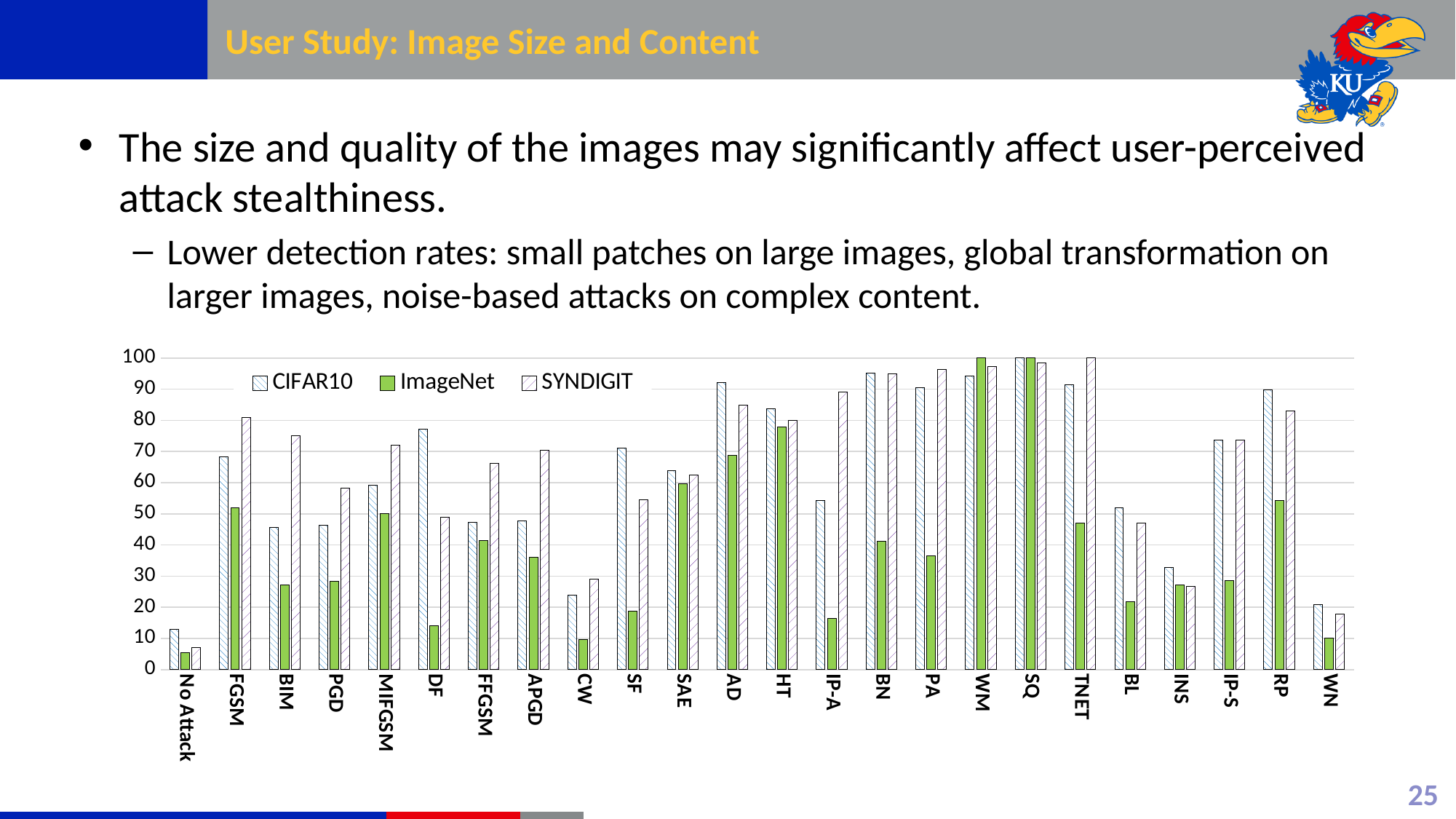
For BN, which series has the larger value, ImageNet or SYNDIGIT? SYNDIGIT How many attack categories are shown along the x axis of the chart? 24 Is the SYNDIGIT value for BIM greater or less than 70? greater For DF, which series has the larger value, CIFAR10 or ImageNet? CIFAR10 Which category has the lowest CIFAR10 value in the chart? No Attack Is the CIFAR10 value for FGSM greater or less than 60? greater How many series does the chart legend list? 3 Is the ImageNet value for IP-A greater or less than 20? less Which series in the chart is drawn with solid green bars? ImageNet Which category has the highest CIFAR10 value in the chart? SQ Which category has the lowest ImageNet value in the chart? No Attack What kind of chart is shown on the slide? bar chart